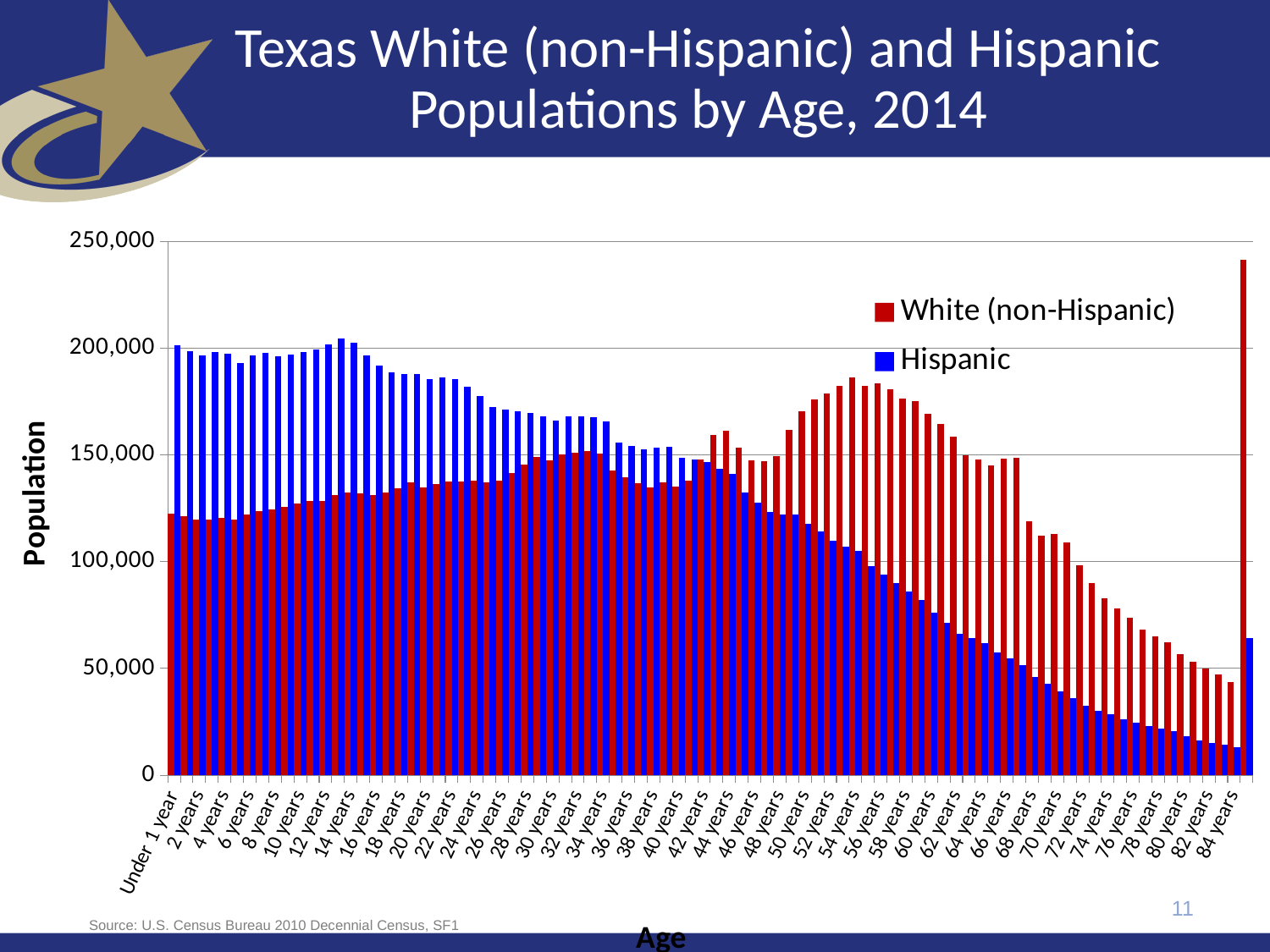
What is the label of the vertical axis? Population At 54 years, which series has the larger value, White (non-Hispanic) or Hispanic? White (non-Hispanic) Is the Hispanic value for 84 years greater or less than 50,000? less Is the Hispanic value for 60 years greater or less than 100,000? less Which colour represents the Hispanic series in the chart? blue At 2 years, which series has the larger value, White (non-Hispanic) or Hispanic? Hispanic Is the White (non-Hispanic) value for 54 years greater or less than 150,000? greater Do the Hispanic values rise or fall from 14 years to 84 years? fall How many series does the legend list? 2 What kind of chart is shown on the slide? bar chart